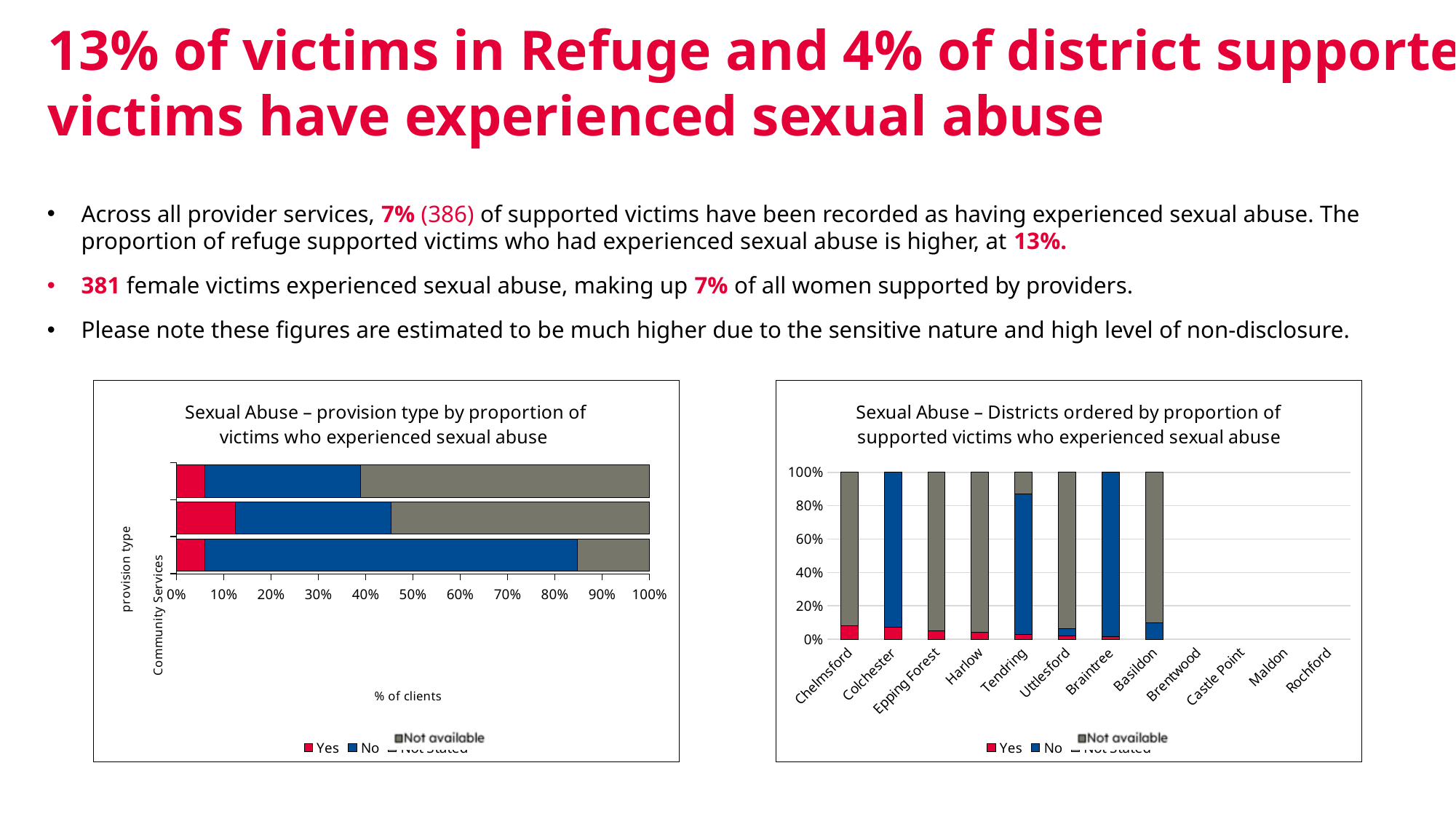
In the districts chart on the right, how many districts have no bar plotted? 4 In the districts chart on the right, is the 'No' share for Tendring greater or less than 80%? greater What is the x-axis title of the provision type chart on the left? % of clients In the provision type chart on the left, is the 'No' share for Community Services greater or less than 60%? greater In the districts chart on the right, is the 'No' share for Basildon greater or less than 20%? less In the districts chart on the right, how many districts are listed on the x axis? 12 What kind of chart is the 'Sexual Abuse – provision type by proportion of victims who experienced sexual abuse' chart? Stacked bar chart In the districts chart on the right, is the 'No' share larger for Colchester or for Basildon? Colchester In the districts chart on the right, how many series does the legend list? 3 In the districts chart on the right, do the 'Yes' shares rise or fall moving from Chelmsford to Basildon? fall What kind of chart is the 'Sexual Abuse – Districts ordered by proportion of supported victims who experienced sexual abuse' chart? Stacked bar chart